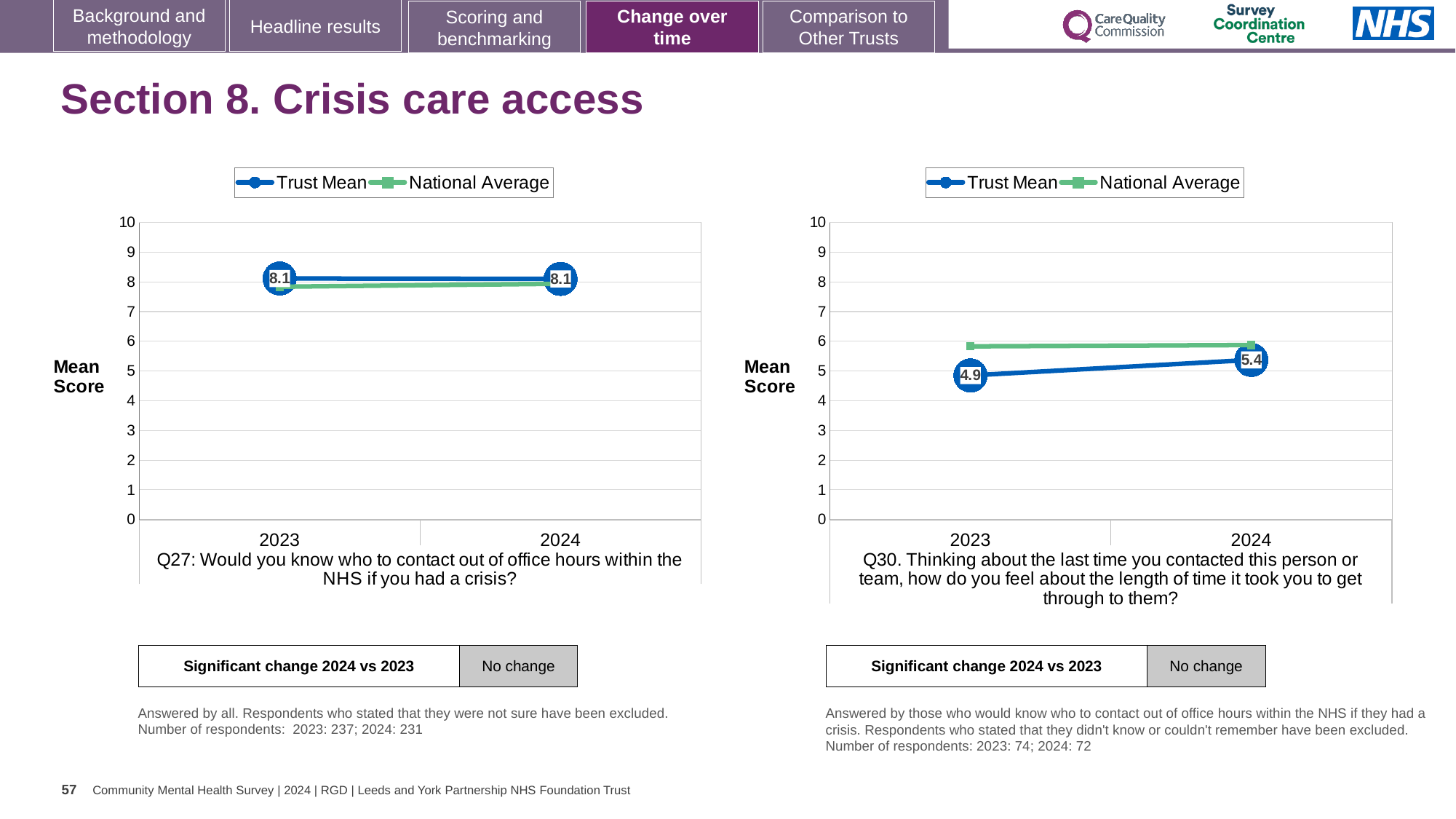
How many years are shown on the x axis of the Q30 chart? 2 In the Q30 chart, which year has the higher Trust Mean, 2023 or 2024? 2024 What type of chart is used for Q30? Line chart In the Q27 chart, what is the Trust Mean score for 2024? 8.1 In the Q30 chart, does the Trust Mean rise or fall from 2023 to 2024? Rise How many series does the legend of the Q27 chart list? 2 In the Q30 chart, by how much did the Trust Mean change from 2023 to 2024? 0.5 In the Q30 chart, what is the Trust Mean score for 2024? 5.4 In the Q27 chart, what is the Trust Mean score for 2023? 8.1 In the Q30 chart, is the National Average for 2023 greater or less than 5? greater In the Q30 chart, what is the Trust Mean score for 2023? 4.9 In the Q27 chart, is the National Average for 2023 greater or less than 7? greater